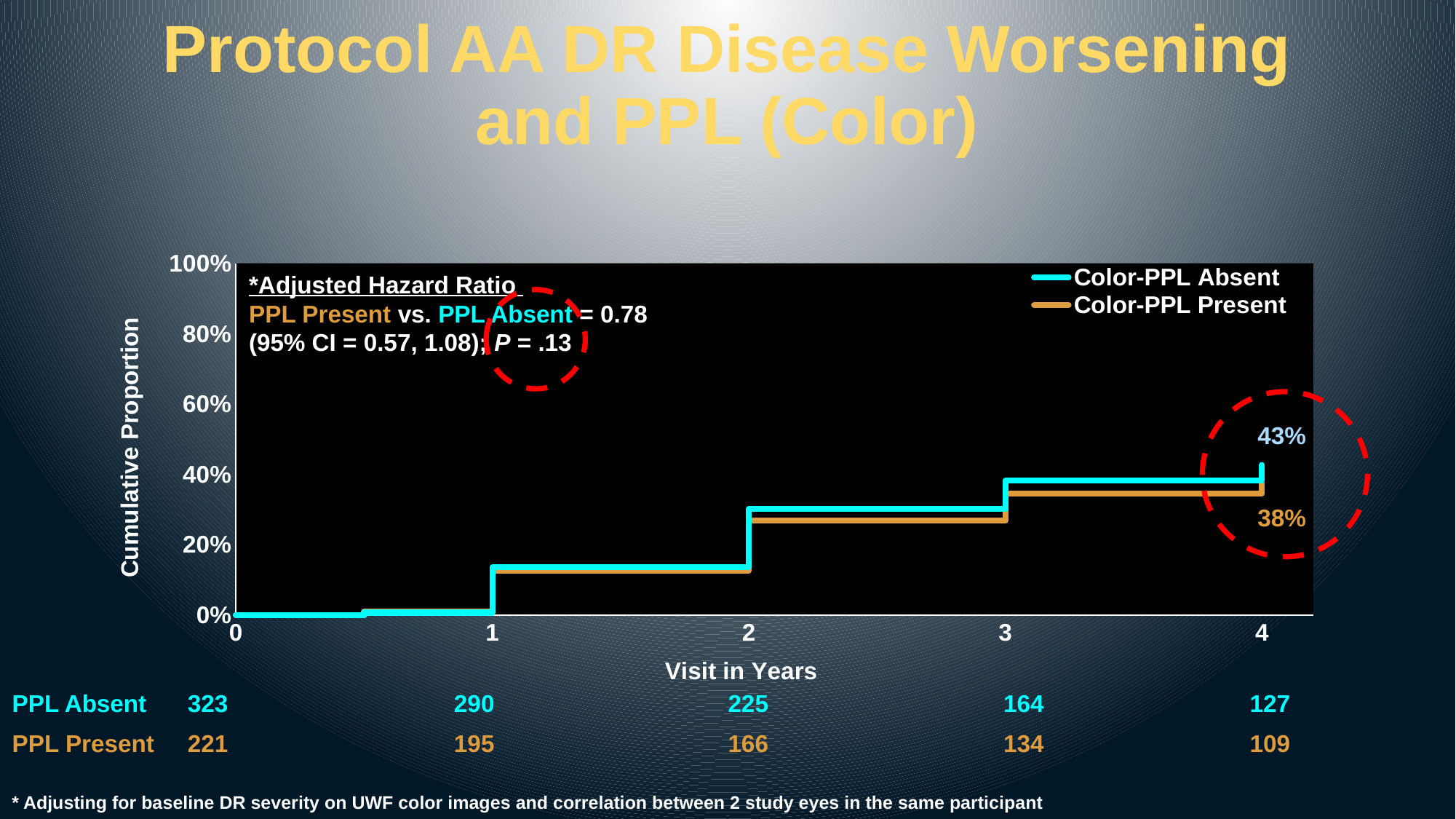
What is the cumulative proportion for Color-PPL Present at year 4? 38% Is the Color-PPL Present value at year 1 greater or less than 20%? less What is the difference between the Color-PPL Absent and Color-PPL Present cumulative proportions at year 4? 5% What is the cumulative proportion for Color-PPL Absent at year 4? 43% How many series does the legend list? 2 At year 4, which group has the higher cumulative proportion, Color-PPL Absent or Color-PPL Present? Color-PPL Absent Do the cumulative proportion curves rise or fall as visit years increase? Rise In the table below the chart, how many PPL Absent participants are listed at year 3? 164 What kind of chart is shown on the slide? Line chart (step curve) Is the Color-PPL Absent value at year 2 greater or less than 40%? less What adjusted hazard ratio is shown on the chart for PPL Present vs. PPL Absent? 0.78 In the table below the chart, how many PPL Present participants are listed at year 0? 221